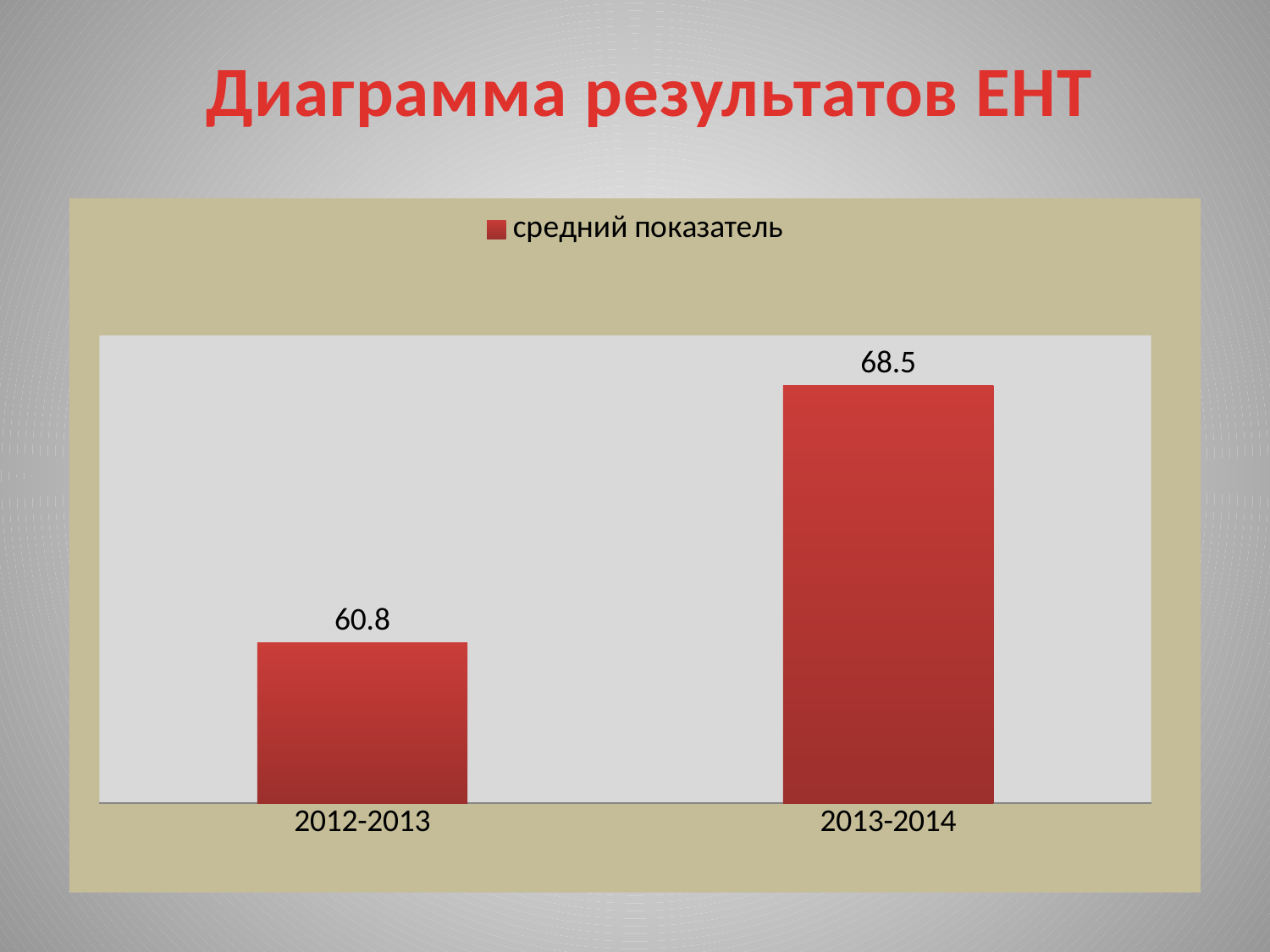
What is the value for 2012-2013? 60.8 How many series does the legend list? 1 Which category has the lowest value? 2012-2013 Do the values rise or fall from 2012-2013 to 2013-2014? rise What is the value for 2013-2014? 68.5 How many categories are shown on the x axis? 2 What kind of chart is shown on the slide? bar chart What is the difference between the values for 2013-2014 and 2012-2013? 7.7 What is the title of the slide? Диаграмма результатов ЕНТ Which category has the highest value? 2013-2014 What series name is shown in the legend? средний показатель Which is larger, the value for 2012-2013 or the value for 2013-2014? 2013-2014